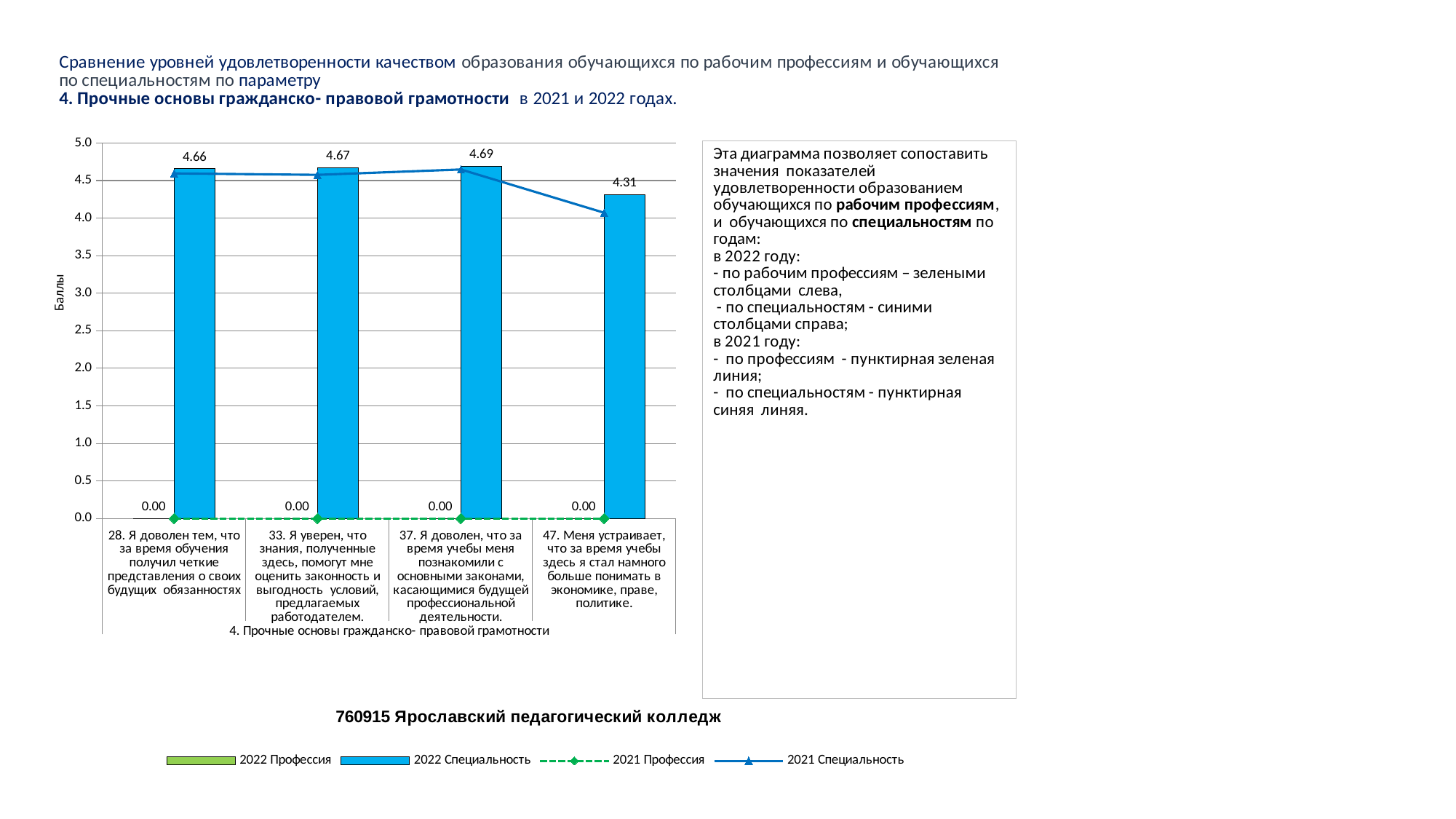
What is the difference between the 2022 Специальность values for item 37 and item 47? 0.38 How many categories are shown on the x axis? 4 What is the title shown below the chart? 760915 Ярославский педагогический колледж Which category has the highest 2022 Специальность value? 37. Я доволен, что за время учебы меня познакомили с основными законами, касающимися будущей профессиональной деятельности. Which category has the lowest 2022 Специальность value? 47. Меня устраивает, что за время учебы здесь я стал намного больше понимать в экономике, праве, политике. What is the value shown for the 2022 Профессия series in each category? 0.00 What is the value of the 2022 Специальность bar for item 28 (Я доволен тем, что за время обучения получил четкие представления о своих будущих обязанностях)? 4.66 What is the value of the 2022 Специальность bar for item 47 (Меня устраивает, что за время учебы здесь я стал намного больше понимать в экономике, праве, политике)? 4.31 Is the 2021 Специальность line value for item 47 greater or less than 4.5? less What is the label of the y axis? Баллы What is the value of the 2022 Специальность bar for item 33 (Я уверен, что знания, полученные здесь, помогут мне оценить законность и выгодность условий, предлагаемых работодателем)? 4.67 How many series does the legend list? 4